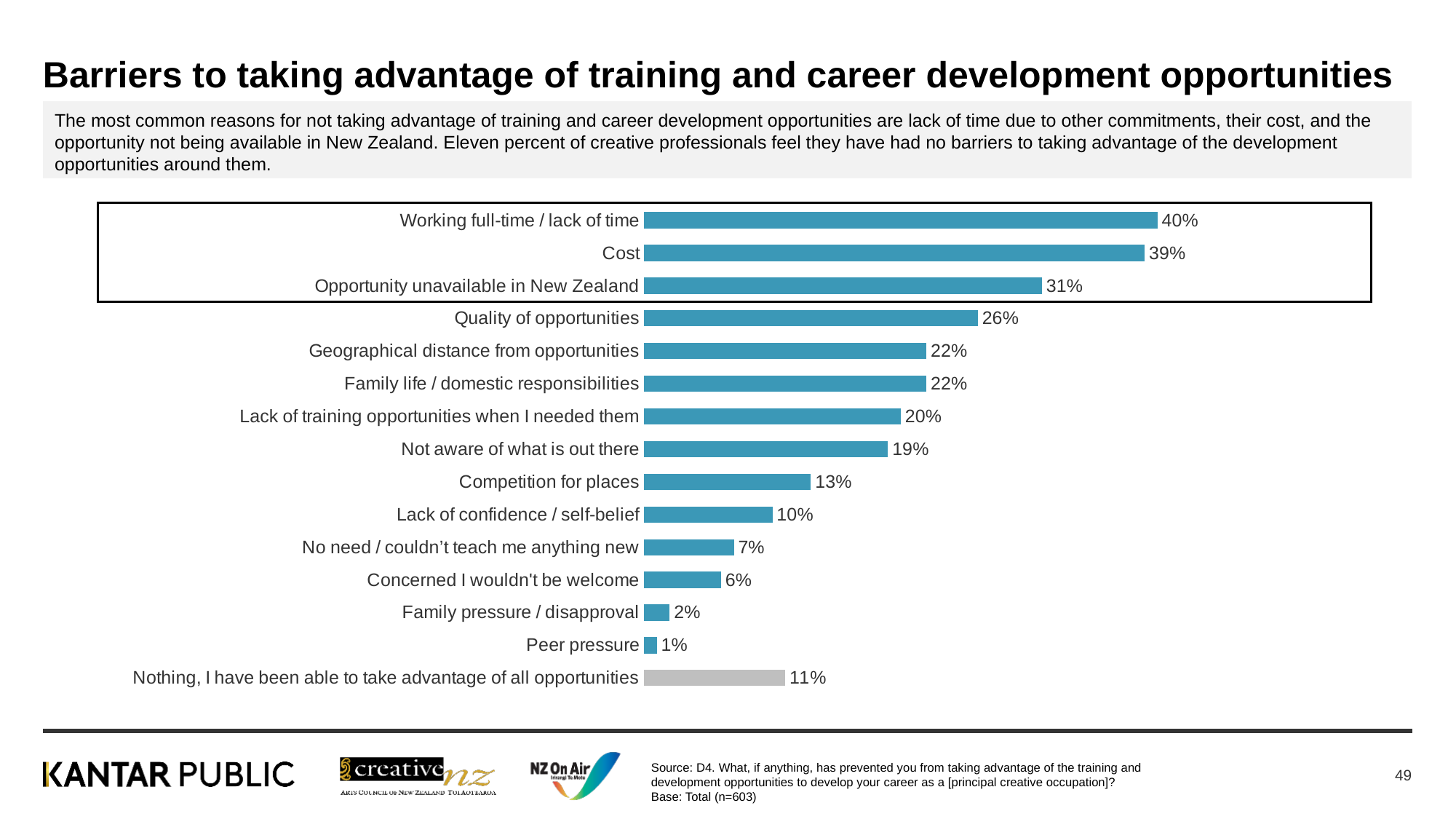
Which bar is shown in grey rather than blue? Nothing, I have been able to take advantage of all opportunities What percentage of respondents cited Cost as a barrier? 39% What is the value for Nothing, I have been able to take advantage of all opportunities? 11% Which is larger, Competition for places or Lack of confidence / self-belief? Competition for places What is the value for Opportunity unavailable in New Zealand? 31% Which barrier has the highest percentage? Working full-time / lack of time Which two categories both have a value of 22%? Geographical distance from opportunities and Family life / domestic responsibilities What type of chart is shown on the slide? Bar chart What percentage is shown for Not aware of what is out there? 19% How many categories are shown in the chart? 15 What is the difference between Working full-time / lack of time and Quality of opportunities? 14 percentage points Which category has the lowest percentage? Peer pressure